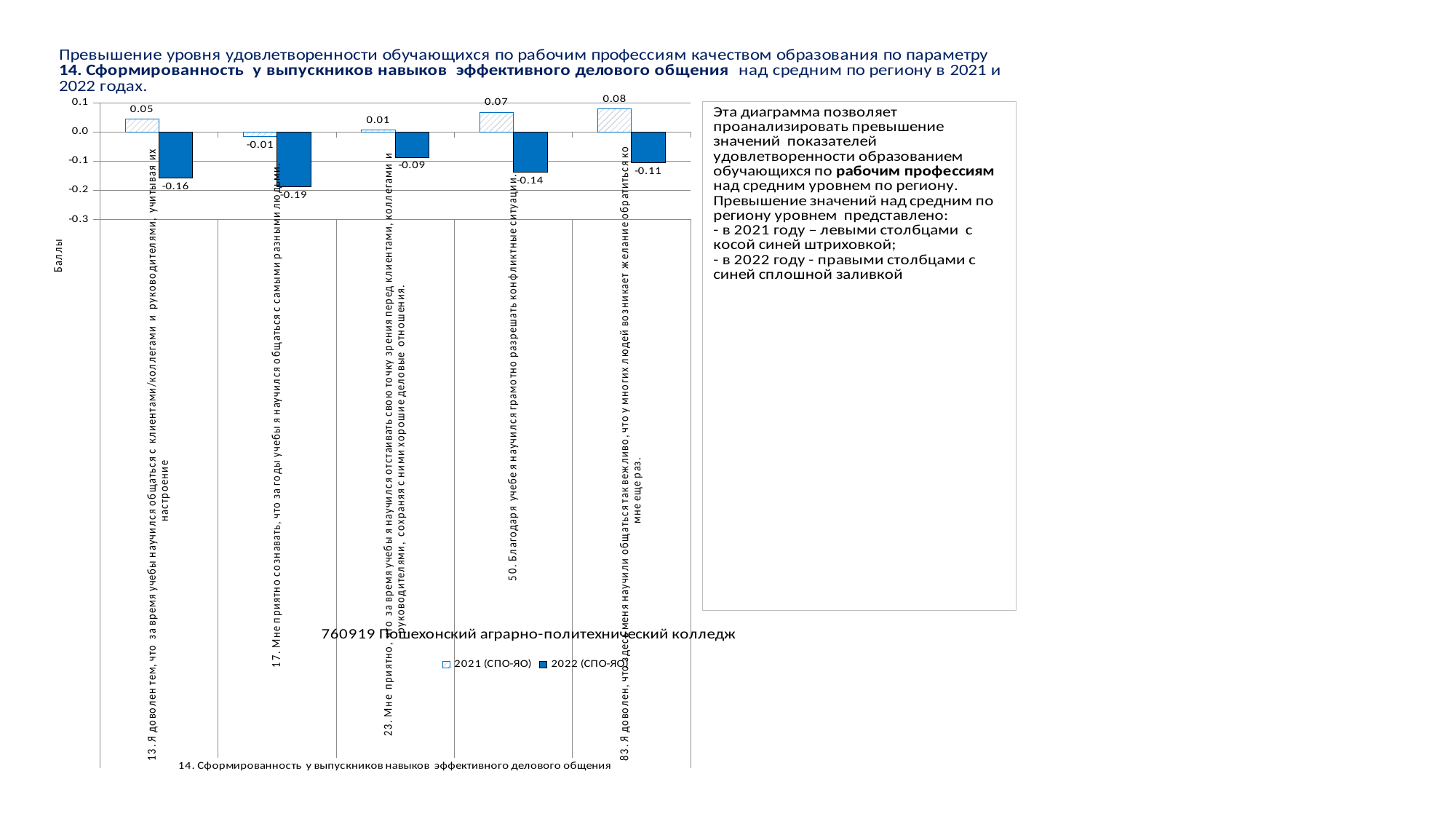
What is the value for the 2021 (СПО-ЯО) series for statement 83? 0.08 What is the value for the 2021 (СПО-ЯО) series for statement 13? 0.05 Which statement has the lowest value in the 2022 (СПО-ЯО) series? 17 What is the value for the 2022 (СПО-ЯО) series for statement 50? -0.14 What is the label of the y axis? Баллы What is the difference between the 2021 and 2022 values for statement 13? 0.21 How many series does the legend list? 2 For statement 23, which series has the larger value, 2021 (СПО-ЯО) or 2022 (СПО-ЯО)? 2021 (СПО-ЯО) What kind of chart is shown on the slide? Bar chart What is the value for the 2022 (СПО-ЯО) series for statement 17? -0.19 Which statement has the highest value in the 2021 (СПО-ЯО) series? 83 How many statements (categories) are shown on the x axis? 5